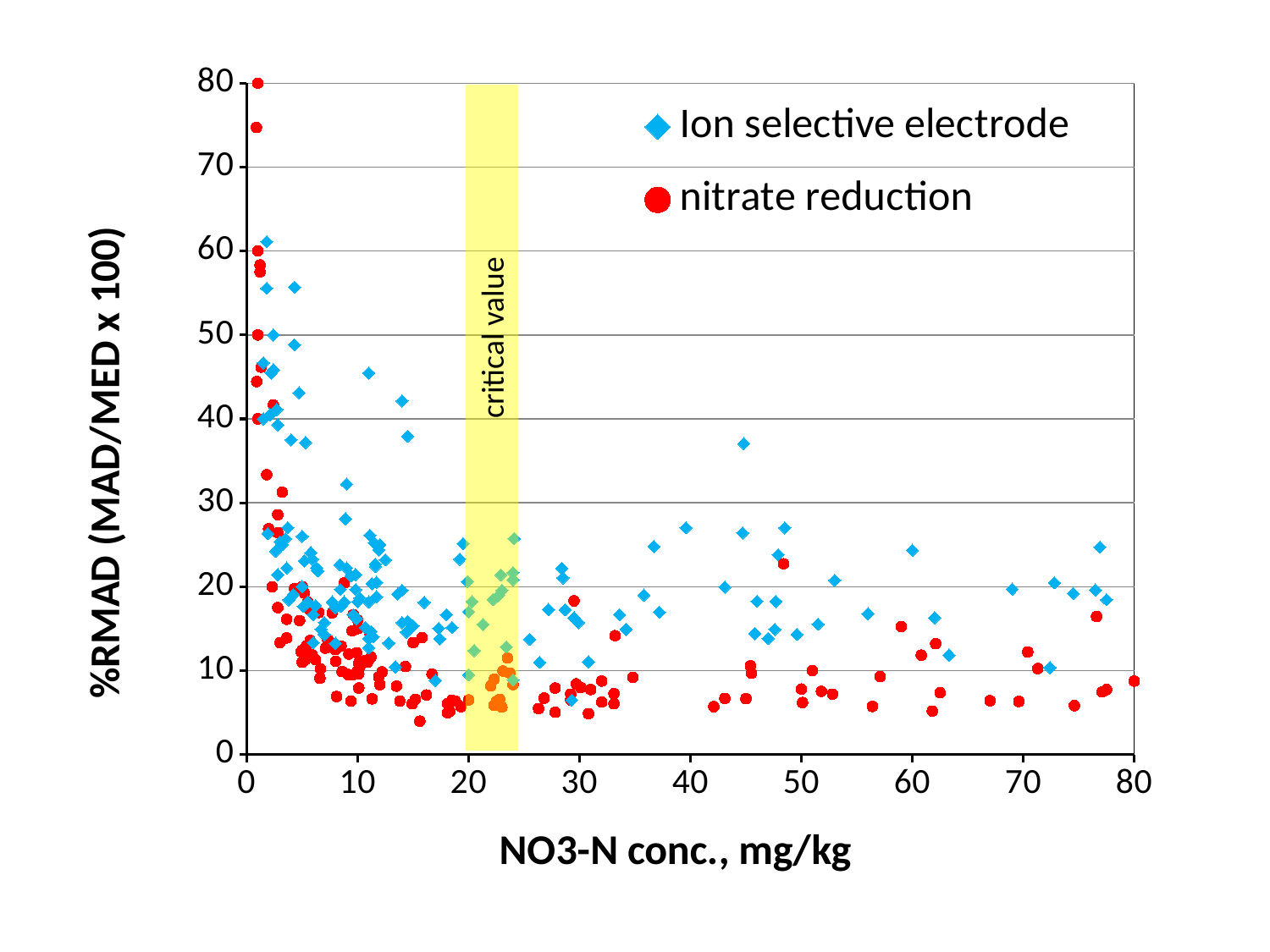
Is the highest nitrate reduction value plotted beyond 40 mg/kg greater or less than 30? less How many series does the legend list? 2 Beyond 40 mg/kg, which series has the larger highest plotted value, Ion selective electrode or nitrate reduction? Ion selective electrode What is the maximum value shown on the y axis? 80 Is the highest plotted Ion selective electrode value greater or less than 70? less Is the highest plotted nitrate reduction value greater or less than 70? greater What label is written on the yellow shaded band? critical value Which series contains the highest plotted %RMAD value on the chart? nitrate reduction Which series is plotted with blue diamond markers? Ion selective electrode Do the %RMAD values generally rise or fall as NO3-N concentration increases along the x axis? fall What kind of chart is shown on the slide? scatter chart